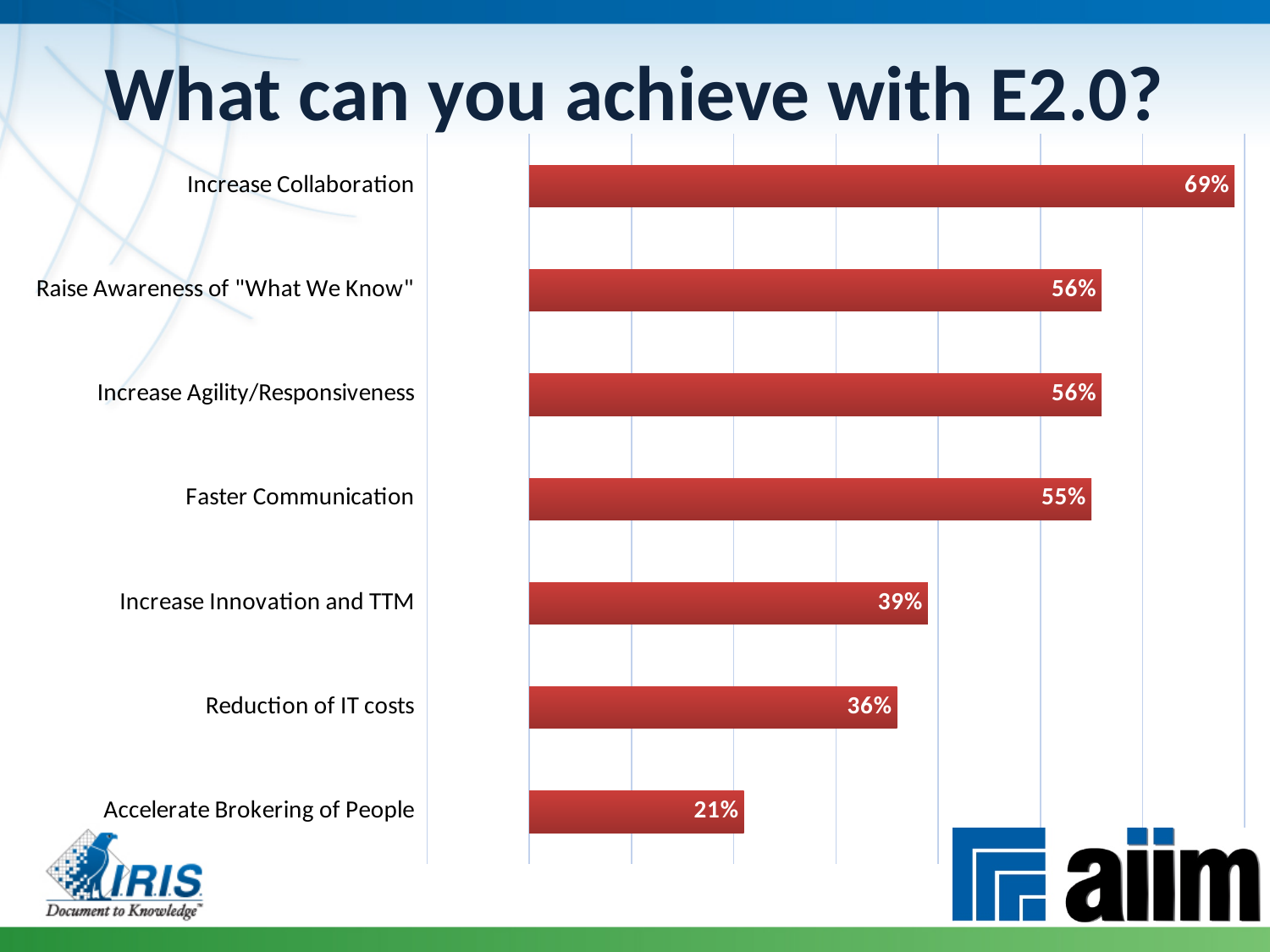
What is the difference between the values for Increase Collaboration and Accelerate Brokering of People? 48% Which category has the lowest value? Accelerate Brokering of People Which is larger, the value for Faster Communication or the value for Increase Innovation and TTM? Faster Communication What kind of chart is shown on the slide? Bar chart What is the title of the slide containing the chart? What can you achieve with E2.0? What is the value for Reduction of IT costs? 36% Which category has the highest value? Increase Collaboration What is the difference between the values for Increase Innovation and TTM and Reduction of IT costs? 3% How many categories are shown in the chart? 7 What is the value for Increase Collaboration? 69% What is the value for Increase Innovation and TTM? 39% What is the value for Faster Communication? 55%